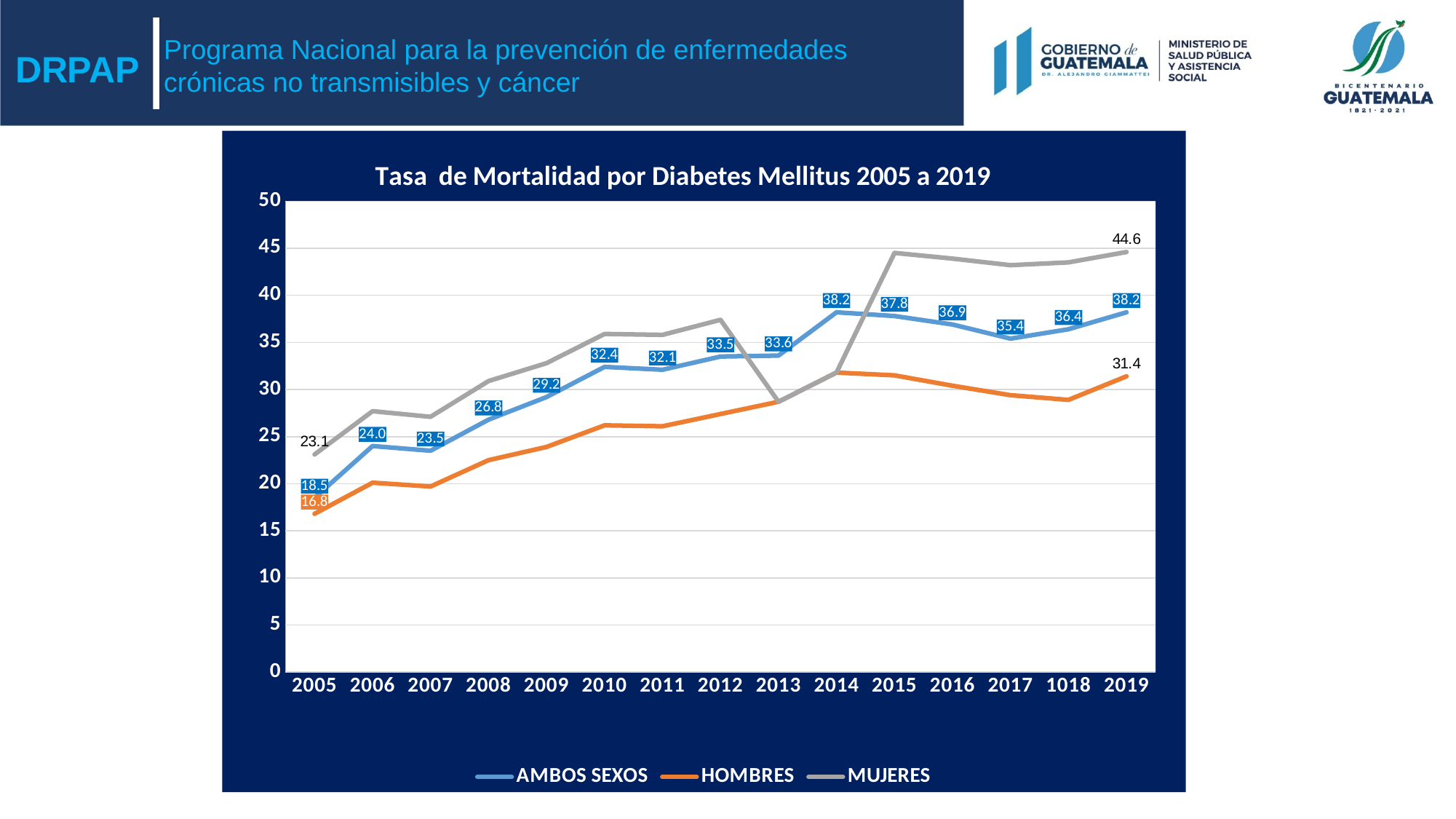
In which year is the AMBOS SEXOS value lowest? 2005 By how much did the AMBOS SEXOS value increase from 2005 to 2019? 19.7 How many years are shown along the x axis? 15 How many series does the legend list? 3 What is the title of the chart? Tasa de Mortalidad por Diabetes Mellitus 2005 a 2019 Which year has the larger AMBOS SEXOS value, 2015 or 2016? 2015 Is the value for MUJERES in 2015 greater or less than 40? greater What is the value for AMBOS SEXOS in 2010? 32.4 What is the value for MUJERES in 2019? 44.6 What is the value for HOMBRES in 2005? 16.8 What is the difference between the MUJERES values in 2019 and 2005? 21.5 What kind of chart is shown on the slide? line chart